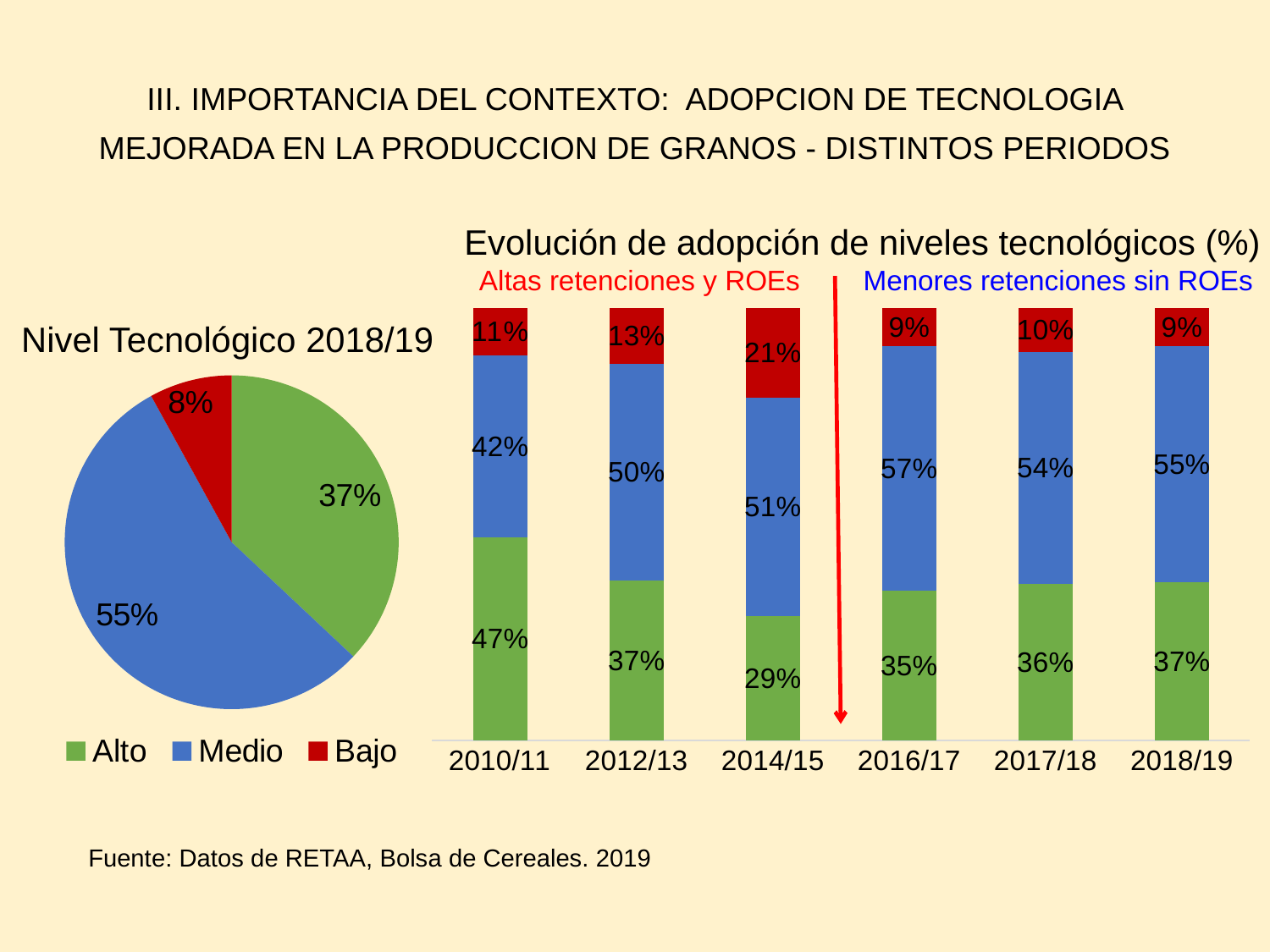
In the chart 'Evolución de adopción de niveles tecnológicos (%)', is the blue (middle) segment larger in 2016/17 or in 2010/11? 2016/17 In the chart 'Evolución de adopción de niveles tecnológicos (%)', which period has the highest value for the green (bottom) segment? 2010/11 In the chart 'Evolución de adopción de niveles tecnológicos (%)', what is the difference between the blue segment values for 2016/17 and 2010/11? 15% In the chart 'Evolución de adopción de niveles tecnológicos (%)', which period has the lowest value for the green (bottom) segment? 2014/15 In the pie chart 'Nivel Tecnológico 2018/19', which category has the smallest slice? Bajo In the chart 'Evolución de adopción de niveles tecnológicos (%)', what is the value of the green (bottom) segment for 2010/11? 47% In the chart 'Evolución de adopción de niveles tecnológicos (%)', how many periods are shown on the x axis? 6 What kind of chart is 'Evolución de adopción de niveles tecnológicos (%)'? Stacked bar chart In the pie chart 'Nivel Tecnológico 2018/19', what share does Medio have? 55% In the pie chart 'Nivel Tecnológico 2018/19', what is the difference between the Medio and Alto shares? 18% In the chart 'Evolución de adopción de niveles tecnológicos (%)', what is the value of the red (top) segment for 2014/15? 21% In the pie chart 'Nivel Tecnológico 2018/19', how many categories does the legend list? 3